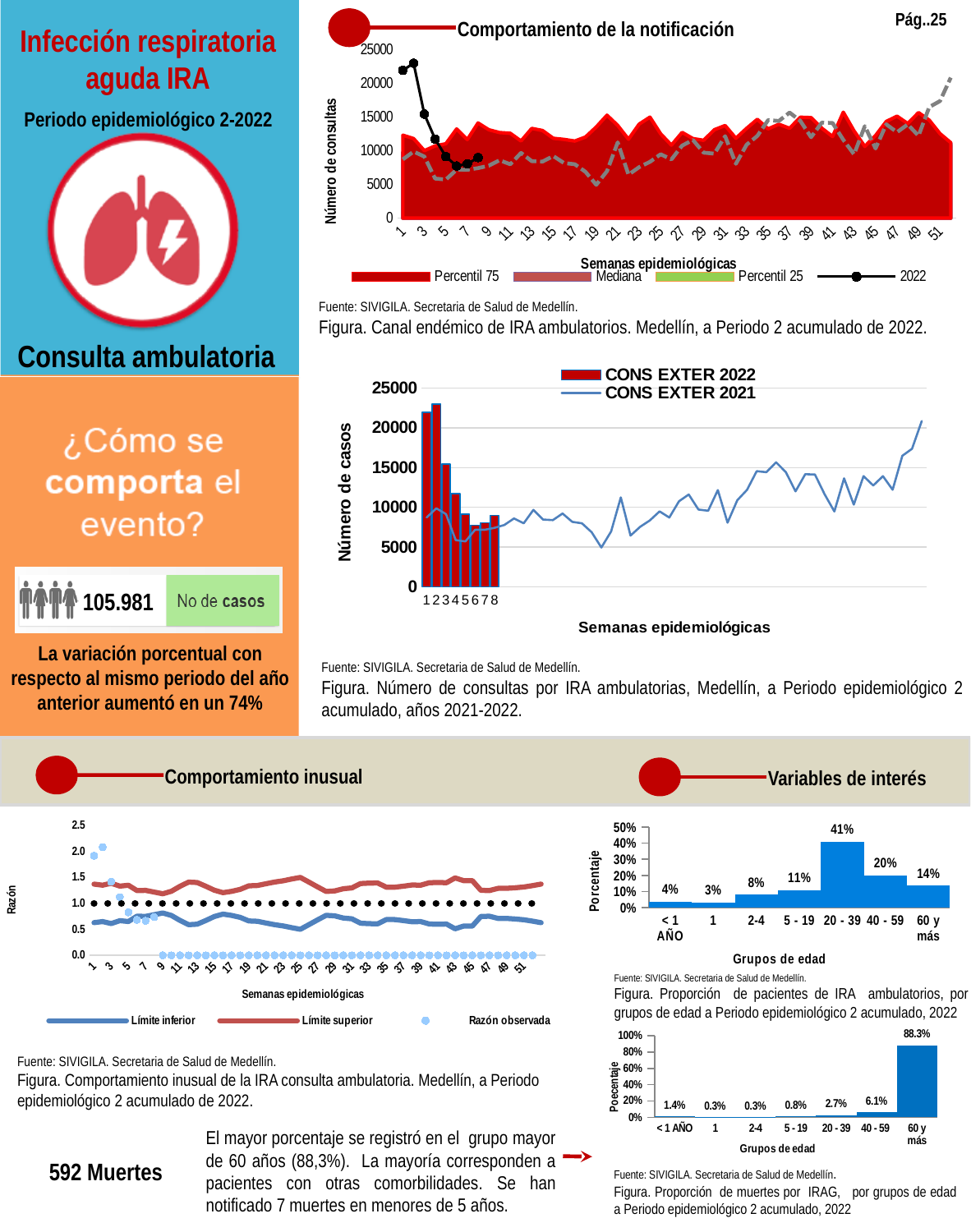
How many series does the legend of the 'Comportamiento inusual' chart list? 3 In the chart 'Proporción de pacientes de IRA ambulatorios, por grupos de edad', what is the difference between the 40 - 59 and 60 y más groups? 6% In the chart 'Proporción de muertes por IRAG, por grupos de edad', what is the value for the < 1 AÑO group? 1.4% In the chart 'Proporción de pacientes de IRA ambulatorios, por grupos de edad', which age group has the lowest percentage? 1 In the chart 'Proporción de pacientes de IRA ambulatorios, por grupos de edad', how many age groups are shown? 7 In the chart 'Proporción de muertes por IRAG, por grupos de edad', what is the value for the 60 y más group? 88.3% What kind of chart is 'Proporción de muertes por IRAG, por grupos de edad'? bar chart In the chart 'Proporción de pacientes de IRA ambulatorios, por grupos de edad', what is the value for the 20 - 39 age group? 41% In the chart 'Proporción de muertes por IRAG, por grupos de edad', what is the difference between the 40 - 59 and 20 - 39 groups? 3.4% In the chart 'Número de consultas por IRA ambulatorias', what are the two series named in the legend? CONS EXTER 2022 and CONS EXTER 2021 How many series does the legend of the 'Comportamiento de la notificación' chart (Canal endémico) list? 4 In the chart 'Proporción de muertes por IRAG, por grupos de edad', which is larger, the value for 40 - 59 or the value for 20 - 39? 40 - 59